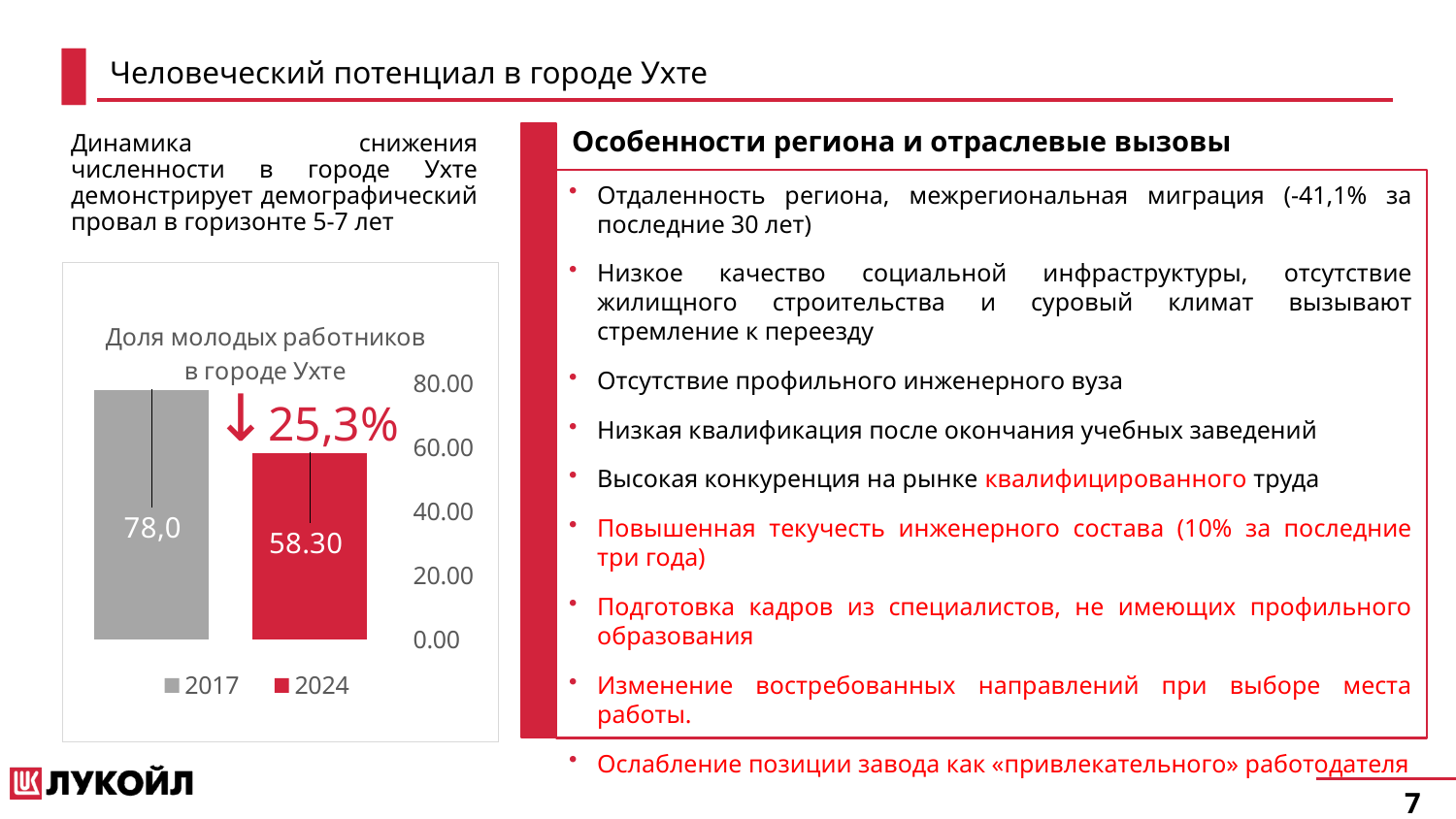
Do the values in the chart rise or fall from 2017 to 2024? fall What is the value for 2017 in the chart? 78,0 Which year has the lowest value in the chart? 2024 Which year has the higher value in the chart, 2017 or 2024? 2017 How many bars are plotted in the chart? 2 What is the value for 2024 in the chart? 58.30 What percentage decrease is annotated on the chart between 2017 and 2024? 25,3% Is the value for 2024 greater or less than 60.00? less What type of chart is shown on the slide? bar chart Is the value for 2017 greater or less than 60.00? greater What is the title of the chart on the slide? Доля молодых работников в городе Ухте How many entries does the chart legend list? 2